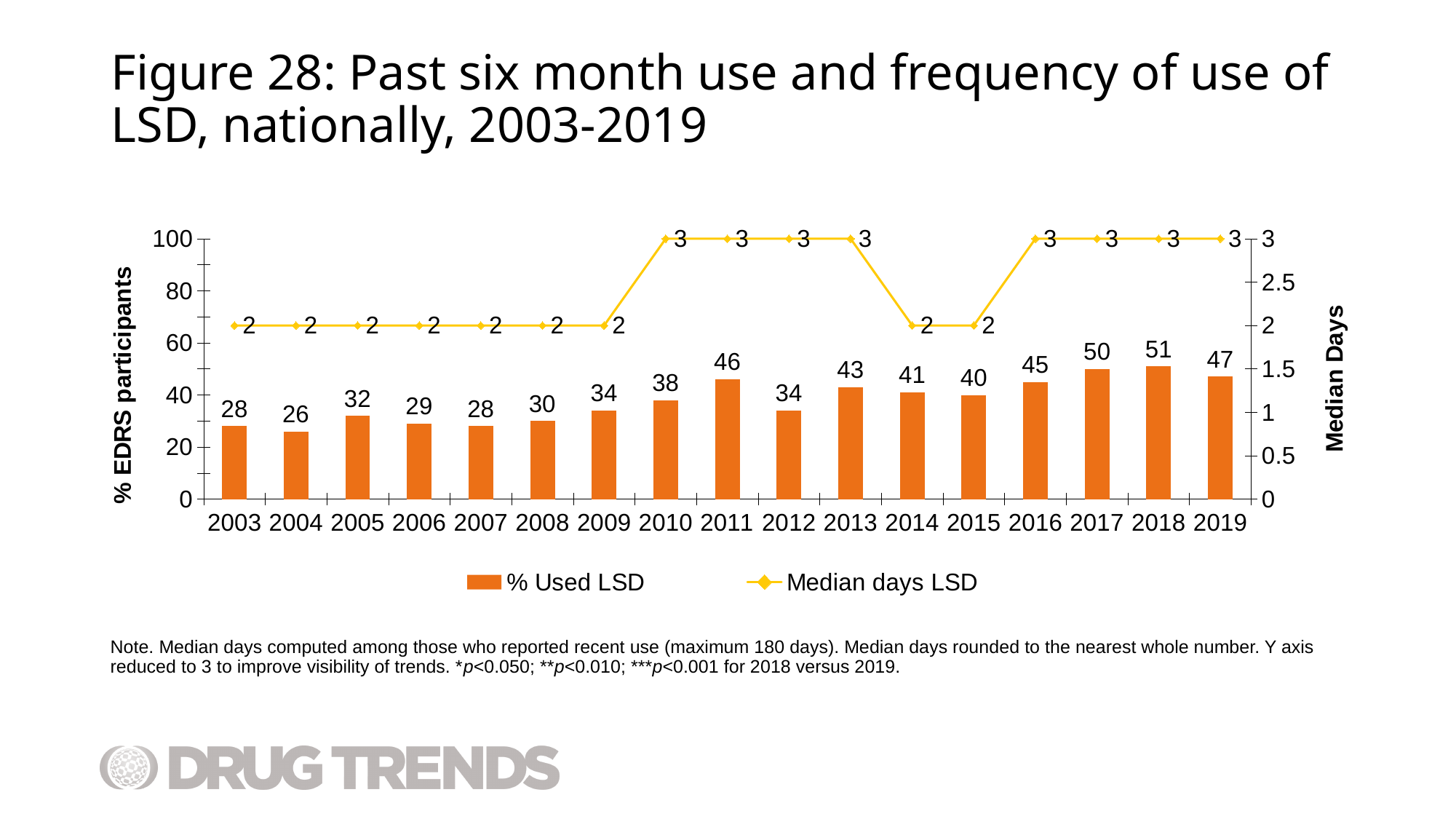
What is the Median days LSD value for 2014? 2 Does the % Used LSD value rise or fall from 2015 to 2018? Rise How many series does the legend list? 2 What is the value of % Used LSD in 2011? 46 What is the label of the right-hand y axis? Median Days How many years are shown on the x axis? 17 Is the % Used LSD value for 2017 greater or less than 40? greater Which year has the highest % Used LSD? 2018 What kind of chart is used to show % Used LSD? Bar chart Which year has the lowest % Used LSD? 2004 What is the difference in % Used LSD between 2018 and 2019? 4 Which year has a higher % Used LSD, 2013 or 2015? 2013